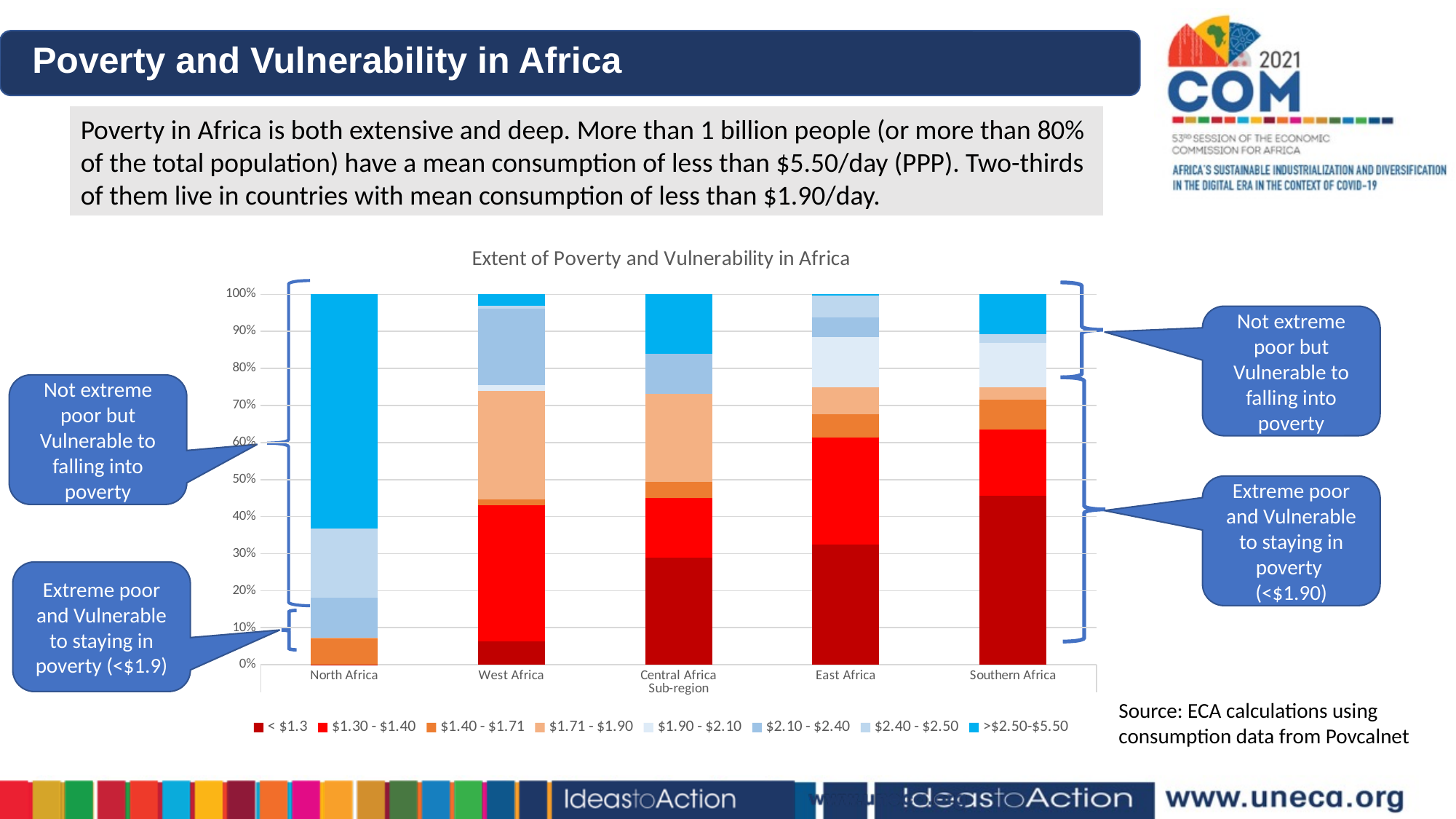
Which sub-region has the largest share in the < $1.3 series? Southern Africa What is the label of the x axis of the chart? Sub-region Is the < $1.3 share larger for Southern Africa or for Central Africa? Southern Africa Which sub-region has the largest share in the $1.30 - $1.40 series? West Africa Is the >$2.50-$5.50 share for North Africa greater or less than 50%? greater Which sub-region has the largest share in the >$2.50-$5.50 series? North Africa What type of chart is shown on the slide? Stacked bar chart How many sub-regions are shown on the x axis of the chart? 5 How many series does the chart legend list? 8 Is the < $1.3 share for Southern Africa greater or less than 40%? greater What is the title of the chart? Extent of Poverty and Vulnerability in Africa Is the $1.40 - $1.71 share for North Africa greater or less than 10%? less